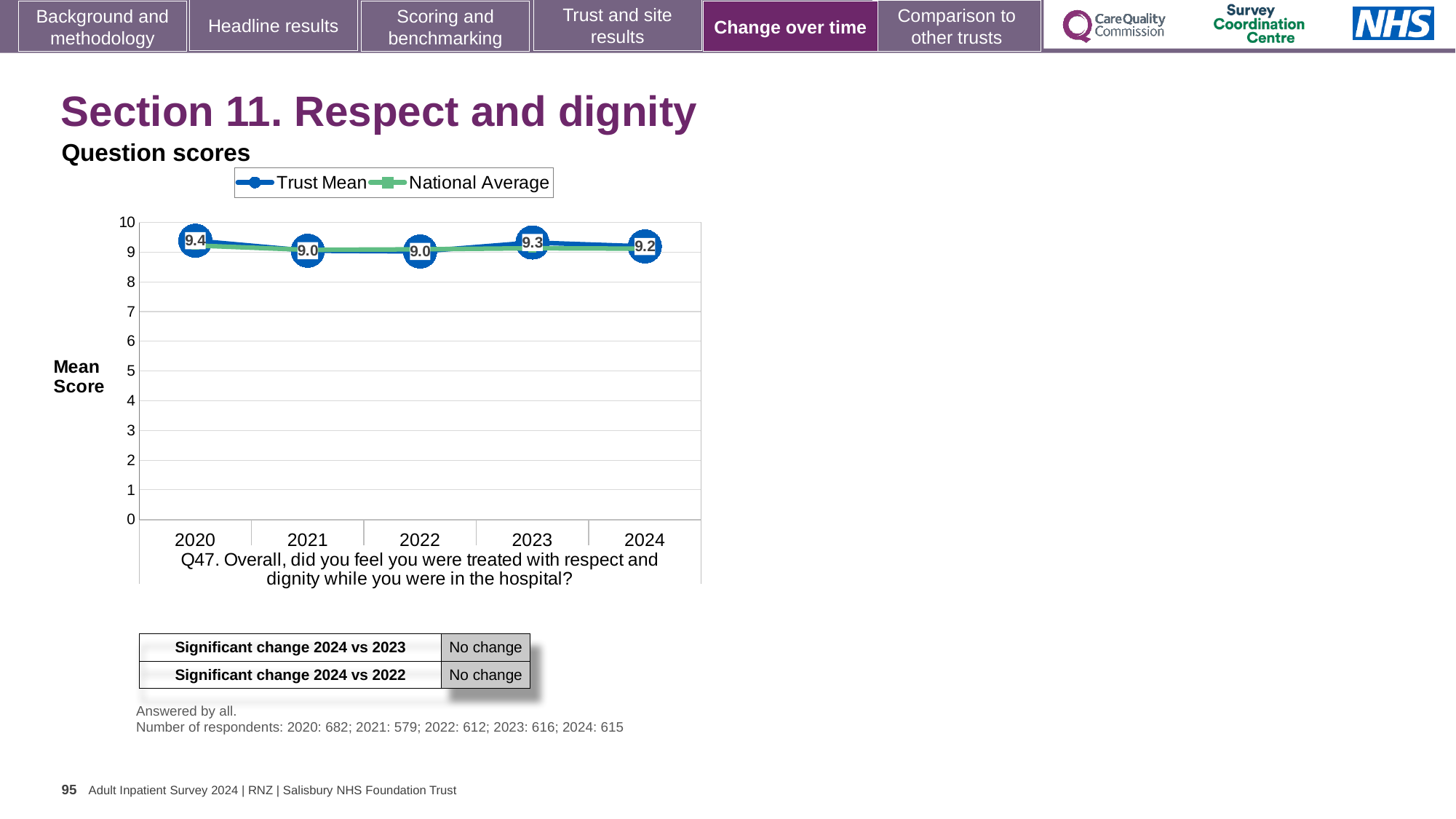
What is the Trust Mean value for 2020? 9.4 How many series does the legend list? 2 Is the National Average value for 2020 greater or less than 8? greater Which is larger, the Trust Mean for 2023 or for 2024? 2023 What is the difference between the Trust Mean in 2020 and in 2021? 0.4 In which year is the Trust Mean highest? 2020 Does the Trust Mean rise or fall from 2020 to 2021? Fall What is the label on the y axis? Mean Score What kind of chart is shown? Line chart What is the Trust Mean value for 2023? 9.3 How many years are plotted on the x axis? 5 What is the Trust Mean value for 2024? 9.2